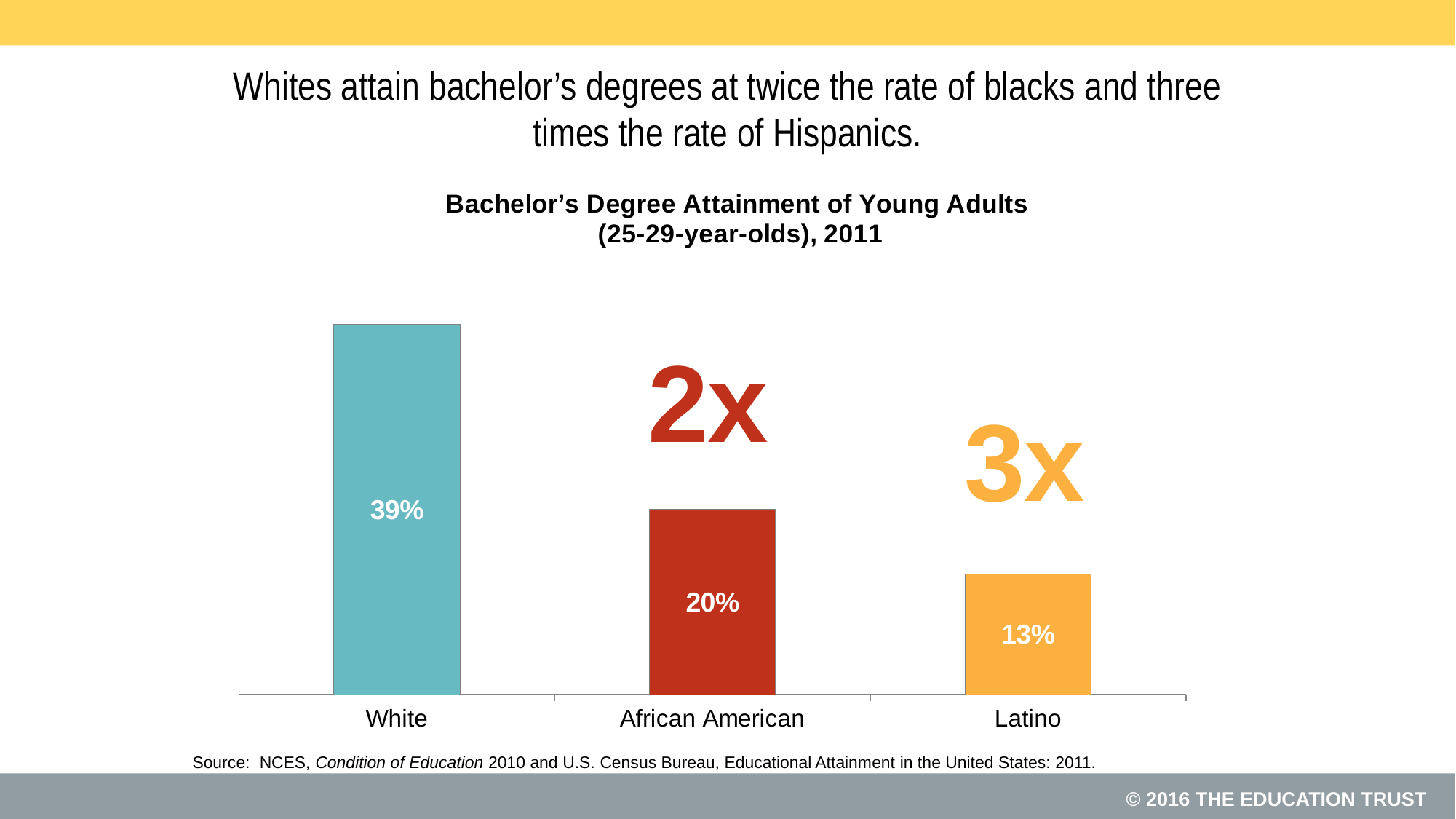
Do the values rise or fall from left to right across the groups? Fall What is the bachelor's degree attainment rate for African American young adults? 20% What is the bachelor's degree attainment rate for White young adults? 39% Which group has the highest bachelor's degree attainment rate? White What is the difference in attainment rate between White and African American young adults? 19% Which group has the lowest bachelor's degree attainment rate? Latino What is the bachelor's degree attainment rate for Latino young adults? 13% What is the title of the chart? Bachelor's Degree Attainment of Young Adults (25-29-year-olds), 2011 Which group has a higher attainment rate, African American or Latino? African American What is the difference in attainment rate between African American and Latino young adults? 7% What kind of chart is shown on the slide? Bar chart How many groups are shown in the chart? 3